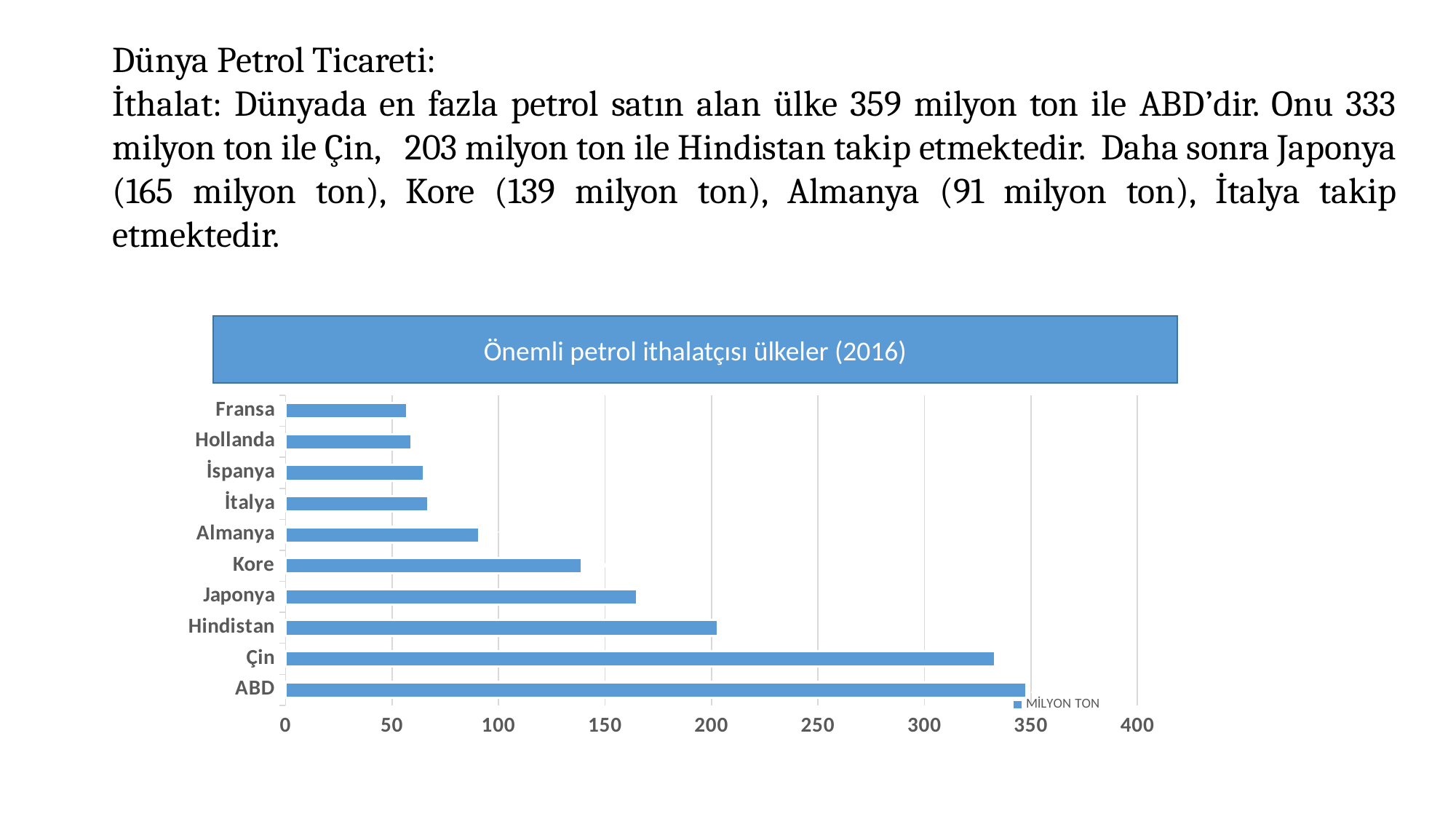
Which country has the lowest value in the chart? Fransa How many series does the legend list? 1 Which country has the highest value in the chart? ABD How many countries are shown in the chart? 10 Which has the larger value, Kore or Japonya? Japonya Is the value for Japonya greater or less than 150? greater What is the title of the chart? Önemli petrol ithalatçısı ülkeler (2016) Is the value for Kore greater or less than 150? less What kind of chart is shown on the slide? bar chart Is the value for Çin greater or less than 300? greater Which has the larger value, Çin or Hindistan? Çin